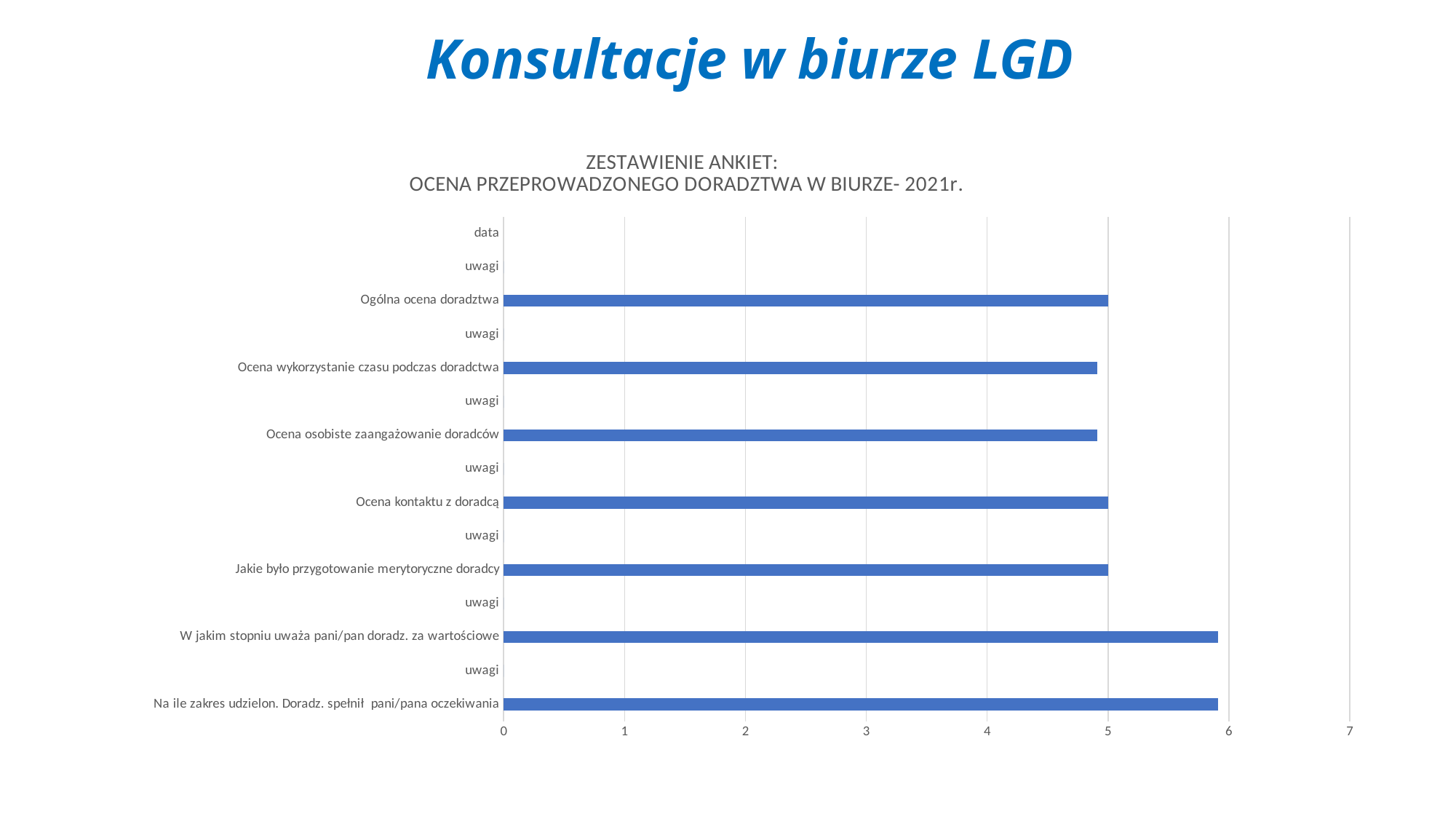
Is the value for 'Na ile zakres udzielon. Doradz. spełnił pani/pana oczekiwania' greater or less than 6? less What is the value for 'Ocena kontaktu z doradcą'? 5 How many bars are plotted in the chart? 7 How many category labels are listed on the vertical axis of the chart? 15 What kind of chart is shown on the slide? bar chart What is the value for 'Ogólna ocena doradztwa'? 5 Which is larger: the value for 'W jakim stopniu uważa pani/pan doradz. za wartościowe' or the value for 'Ogólna ocena doradztwa'? W jakim stopniu uważa pani/pan doradz. za wartościowe Is the value for 'W jakim stopniu uważa pani/pan doradz. za wartościowe' greater or less than 5? greater What is the highest value shown on the horizontal axis of the chart? 7 What is the value for 'Jakie było przygotowanie merytoryczne doradcy'? 5 Is the value for 'Ocena wykorzystanie czasu podczas doradztwa' greater or less than 5? less What is the title of the chart? ZESTAWIENIE ANKIET: OCENA PRZEPROWADZONEGO DORADZTWA W BIURZE- 2021r.